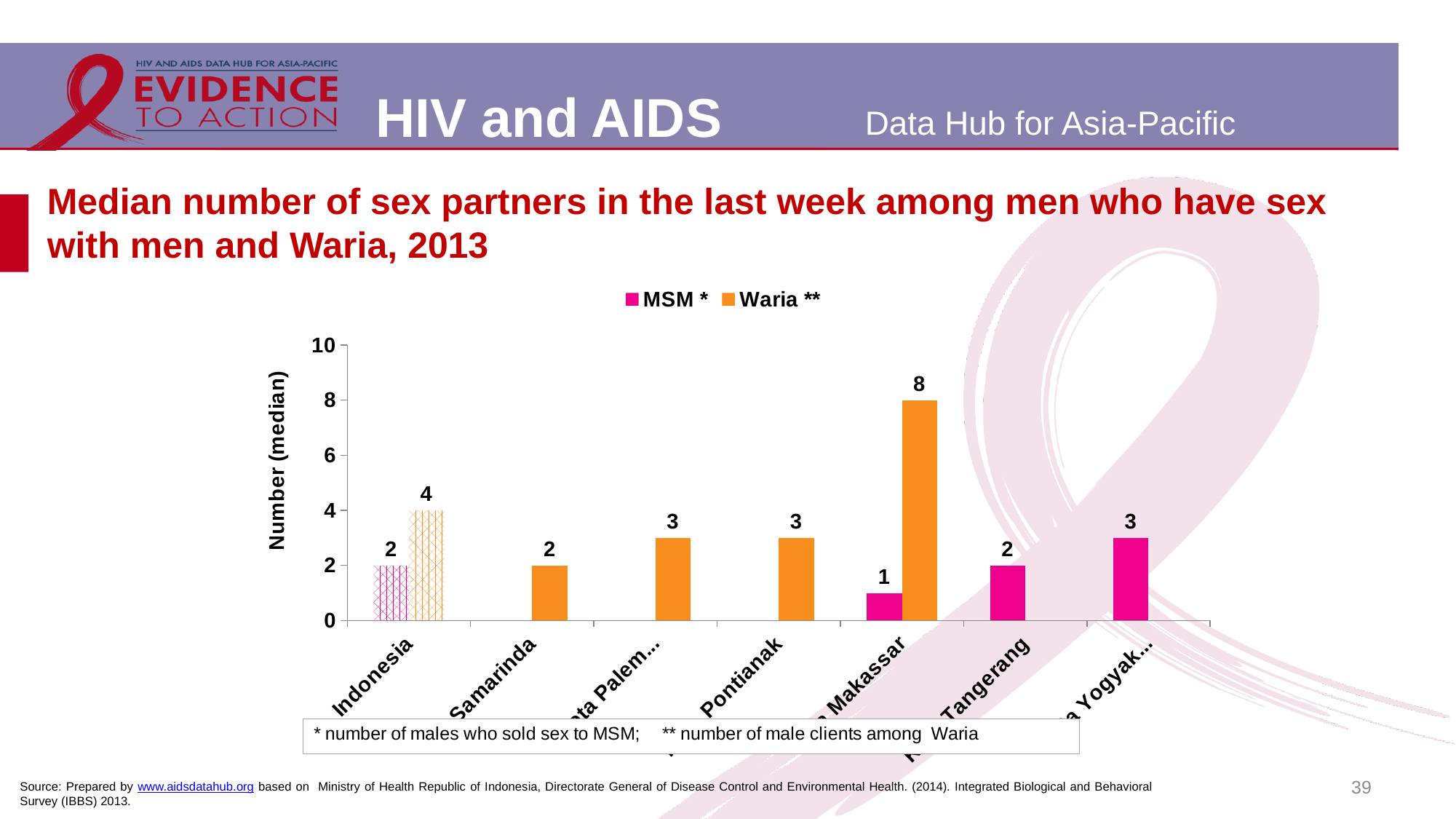
What is the Waria ** value for Samarinda? 2 What is the MSM * value for Makassar? 1 What is the MSM * value for Tangerang? 2 Which location has the highest Waria ** value? Makassar What is the difference between the Waria ** and MSM * values for Makassar? 7 What kind of chart is shown on the slide? Bar chart What is the Waria ** value for Makassar? 8 For Indonesia, which series has the larger value, MSM * or Waria **? Waria ** What is the Waria ** value for Pontianak? 3 How many series does the legend list? 2 What is the MSM * value for Indonesia? 2 What is the Waria ** value for Indonesia? 4